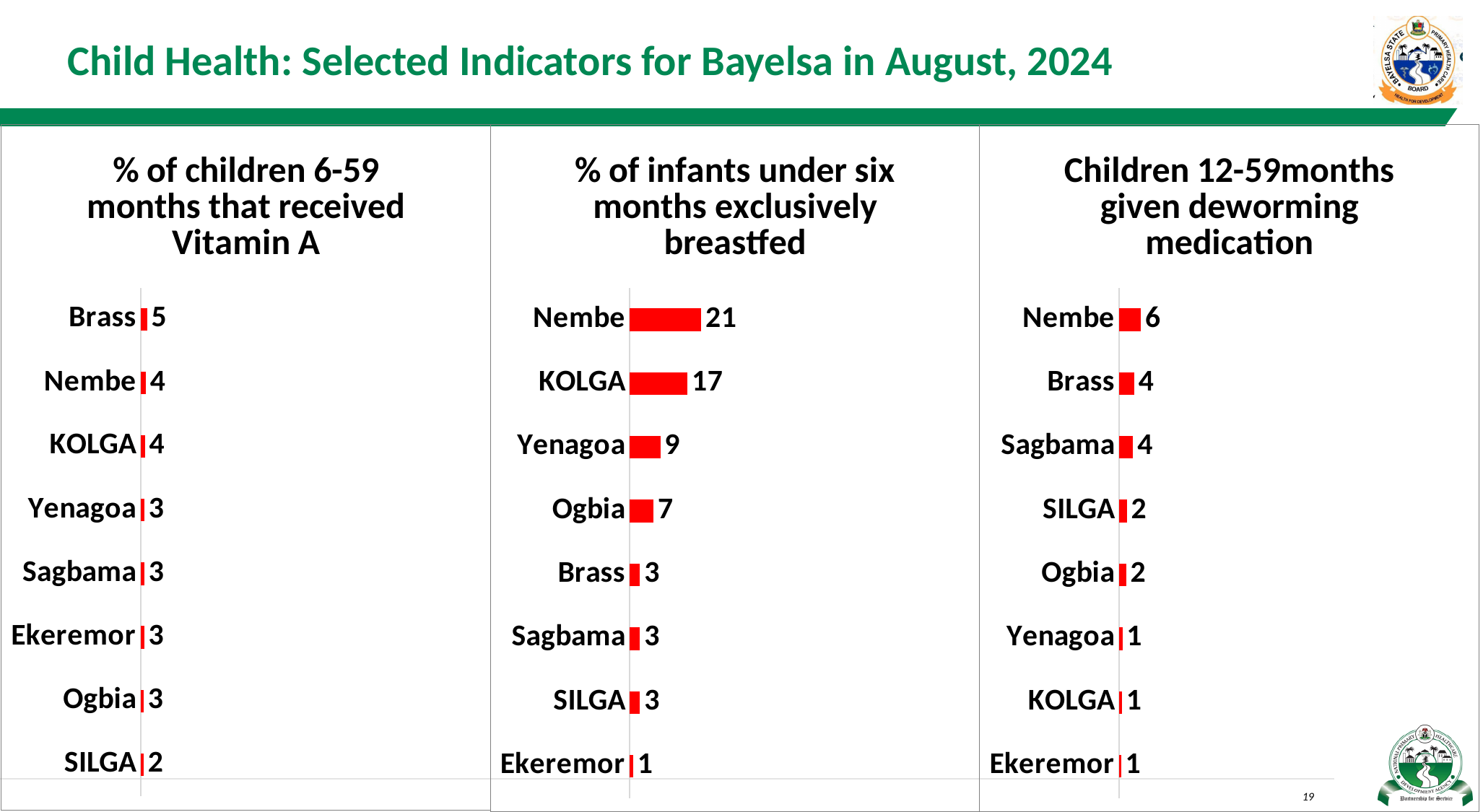
In the '% of children 6-59 months that received Vitamin A' chart, which LGA has the lowest value? SILGA In the 'Children 12-59months given deworming medication' chart, which is larger, Brass or SILGA? Brass In the 'Children 12-59months given deworming medication' chart, what is the value for Nembe? 6 In the '% of infants under six months exclusively breastfed' chart, what is the value for KOLGA? 17 In the 'Children 12-59months given deworming medication' chart, how many LGAs are shown? 8 In the '% of infants under six months exclusively breastfed' chart, what is the difference between Nembe and Yenagoa? 12 What type of chart is the '% of infants under six months exclusively breastfed' chart? Bar chart How many charts are shown on the slide? 3 In the '% of infants under six months exclusively breastfed' chart, which LGA has the lowest value? Ekeremor In the '% of children 6-59 months that received Vitamin A' chart, what is the value for Brass? 5 In the '% of children 6-59 months that received Vitamin A' chart, what is the difference between Brass and SILGA? 3 In the '% of infants under six months exclusively breastfed' chart, which LGA has the highest value? Nembe